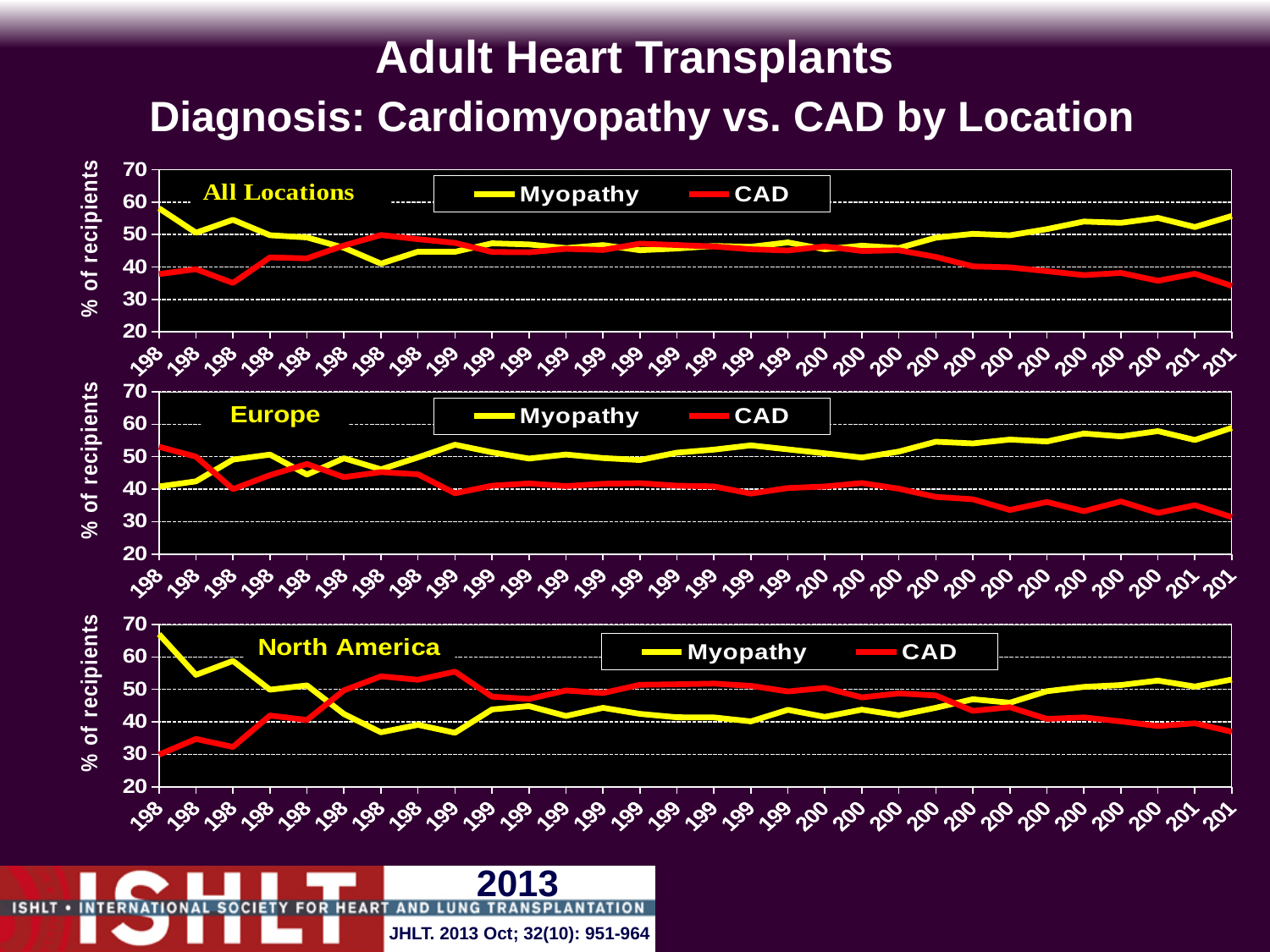
In the Europe chart, at the rightmost point, which series has the higher value, Myopathy or CAD? Myopathy What kind of chart is used in the All Locations panel? line chart In the North America chart, which series reaches the highest value anywhere on the chart? Myopathy In the Europe chart, does the CAD line rise or fall from the left to the right of the x axis? fall How many series does the legend of the Europe chart list? 2 In the North America chart, is the value for Myopathy at the leftmost point greater or less than 60? greater In the North America chart, which colour is the CAD line? red In the North America chart, at the leftmost point, which series has the higher value, Myopathy or CAD? Myopathy In the Europe chart, does the Myopathy line rise or fall from the left to the right of the x axis? rise In the All Locations chart, is the value for CAD at the rightmost point greater or less than 40? less How many charts are shown on the slide? 3 In the Europe chart, is the value for CAD at the rightmost point greater or less than 40? less